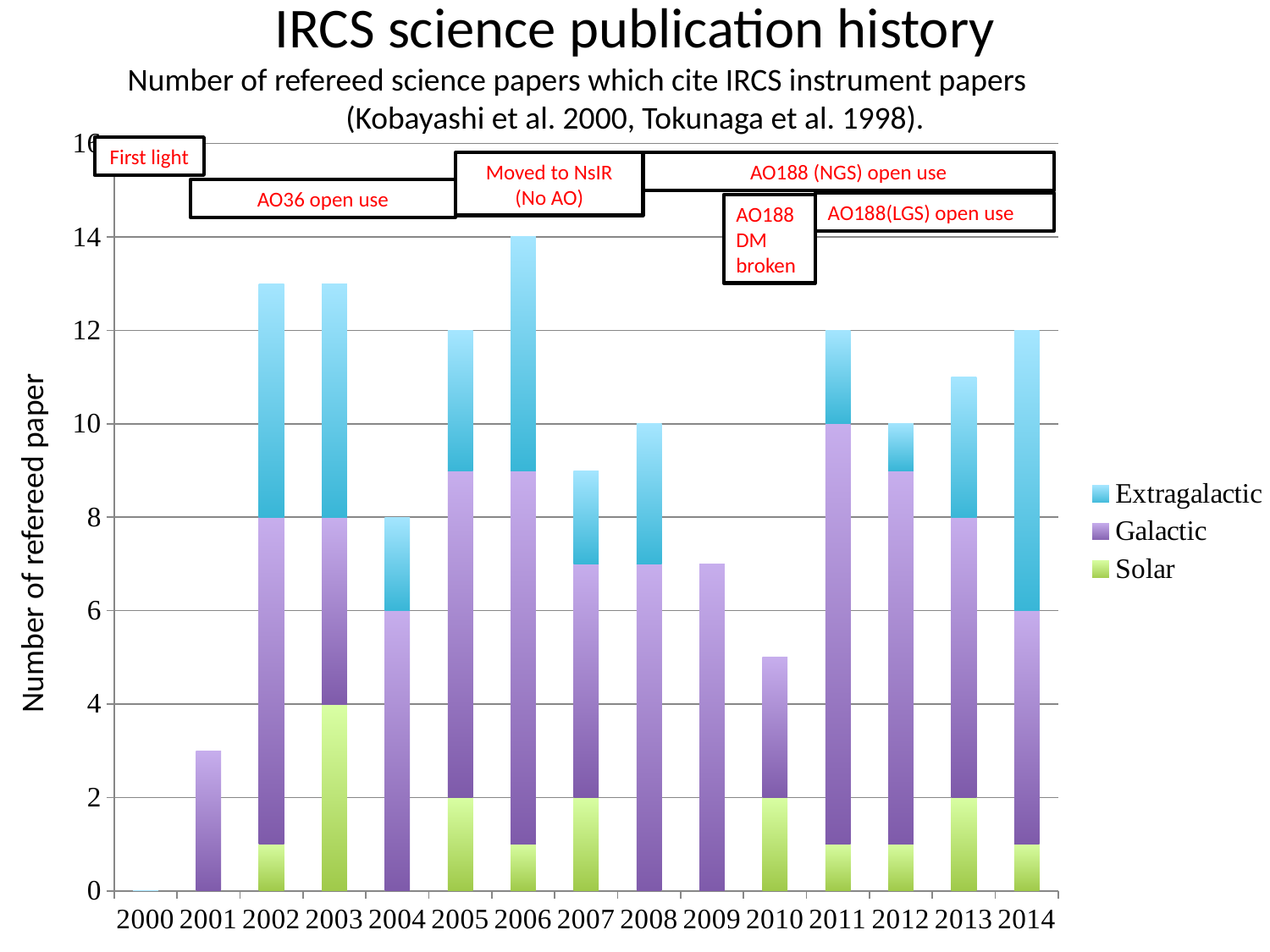
How many series does the legend list? 3 Which year has the highest total number of refereed papers? 2006 Do the totals rise or fall from 2000 to 2002? rise Is the total for 2013 greater or less than 10? greater What is the total number of refereed papers in 2006? 14 What kind of chart is shown on the slide? Stacked bar chart What are the three series named in the legend? Extragalactic, Galactic, Solar Which year has the larger total, 2002 or 2004? 2002 Is the total for 2009 greater or less than 8? less What is the Solar value for 2003? 4 How many years are shown along the x axis? 15 What is the total number of refereed papers in 2004? 8